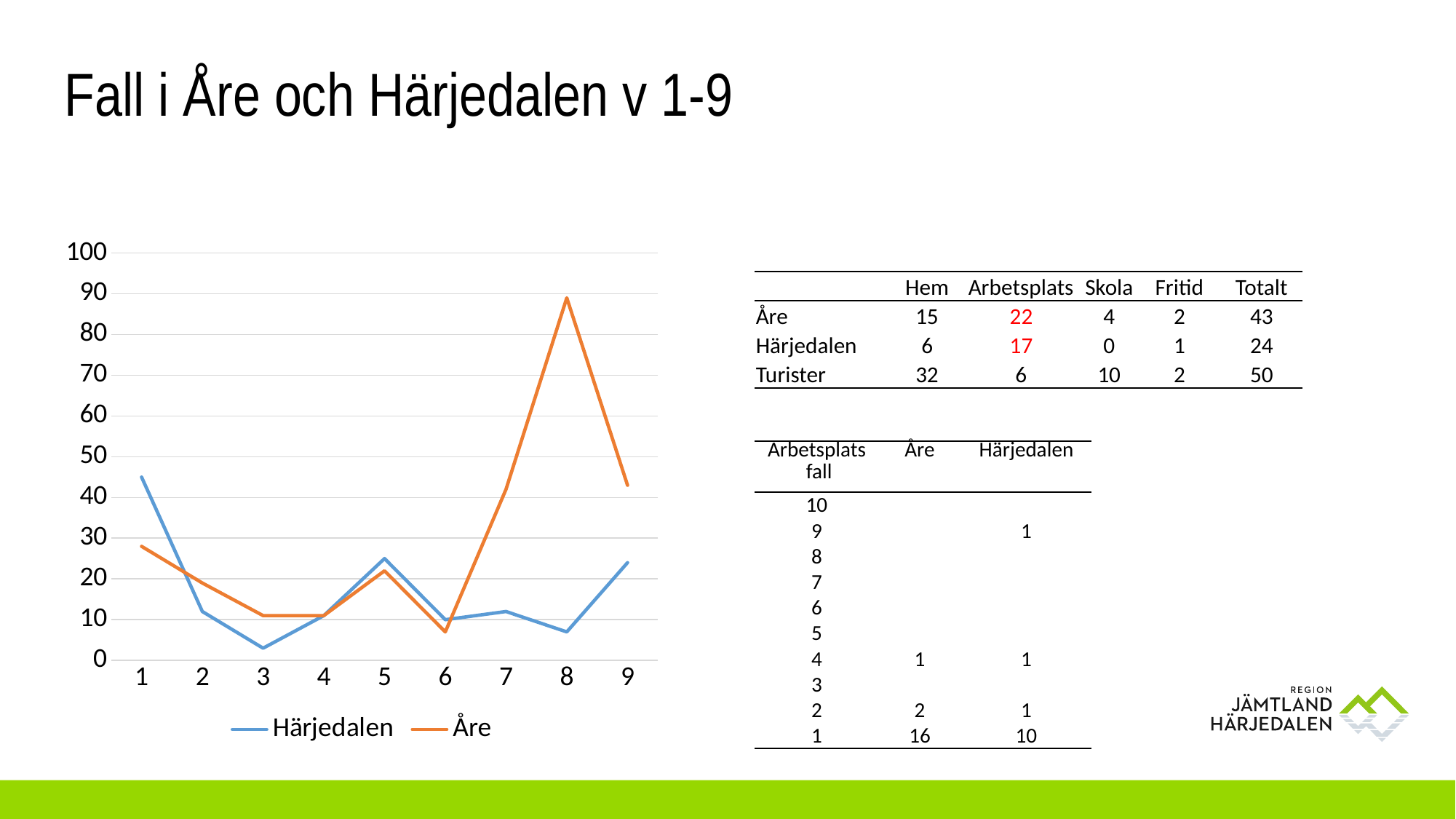
How many series does the chart legend list? 2 Does the Åre line rise or fall from week 6 to week 8? rise How many points (weeks) are plotted along the x axis of the chart? 9 What colour is the Åre line in the chart? orange Is the value for Härjedalen at week 1 greater or less than 40? greater At which week does the Härjedalen line reach its highest value? 1 What kind of chart is shown on the slide? line chart At week 1, which series has the larger value, Härjedalen or Åre? Härjedalen Is the value for Åre at week 8 greater or less than 80? greater At which week does the Åre line reach its highest value? 8 At week 8, which series has the larger value, Åre or Härjedalen? Åre At which week does the Härjedalen line reach its lowest value? 3